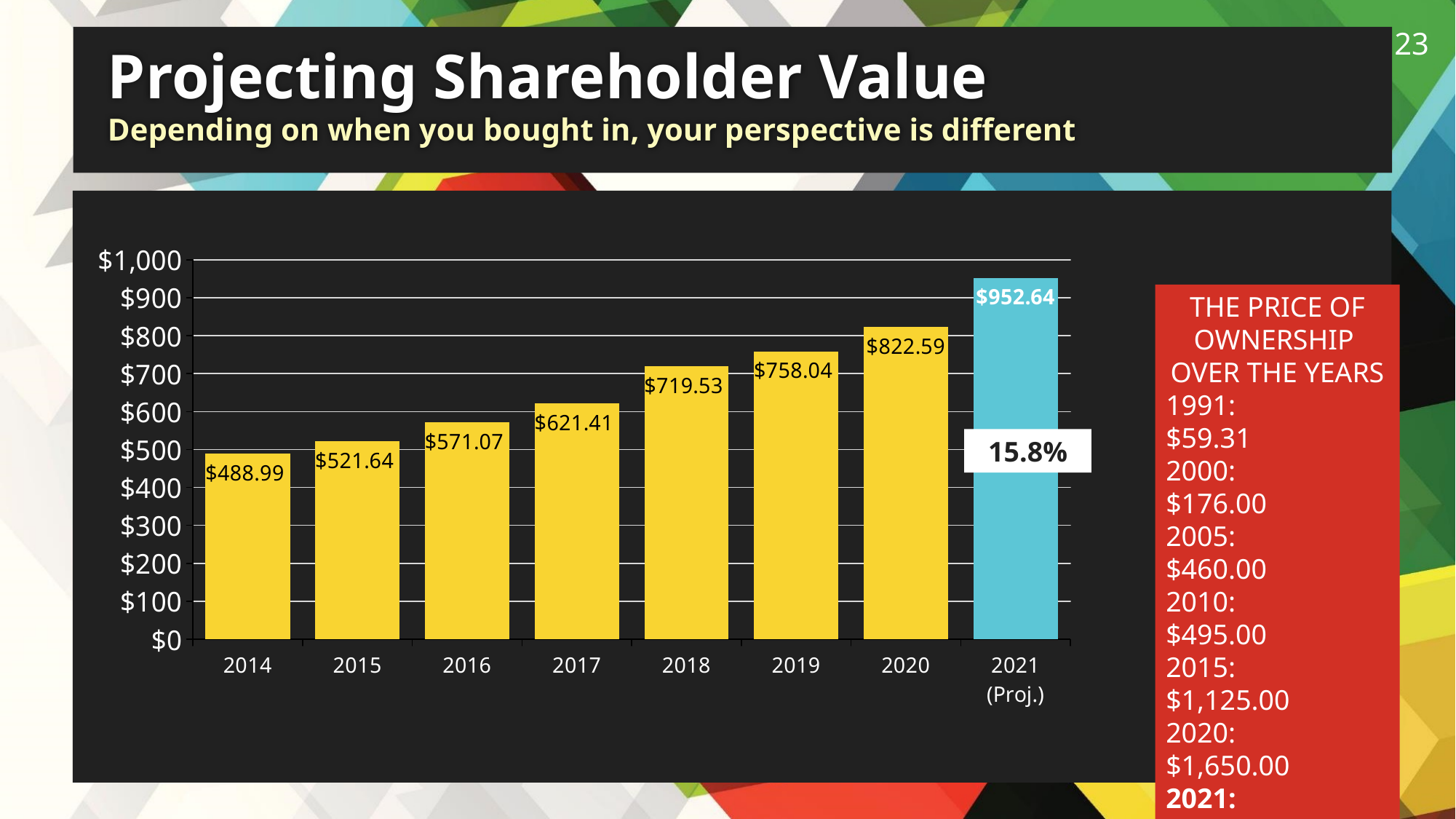
Is the value for 2019 greater or less than $700? greater Do the values rise or fall from 2014 to 2021? rise Which year has the highest value on the chart? 2021 (Proj.) What kind of chart is shown on the slide? bar chart Which year has the lowest value on the chart? 2014 Which is larger, the value for 2016 or the value for 2017? 2017 What is the value shown for 2014? $488.99 What is the value shown for 2018? $719.53 How many years are shown on the x axis of the chart? 8 What percentage is printed on the 2021 (Proj.) bar? 15.8% What is the projected value for 2021? $952.64 What is the difference between the 2020 value and the 2019 value? $64.55